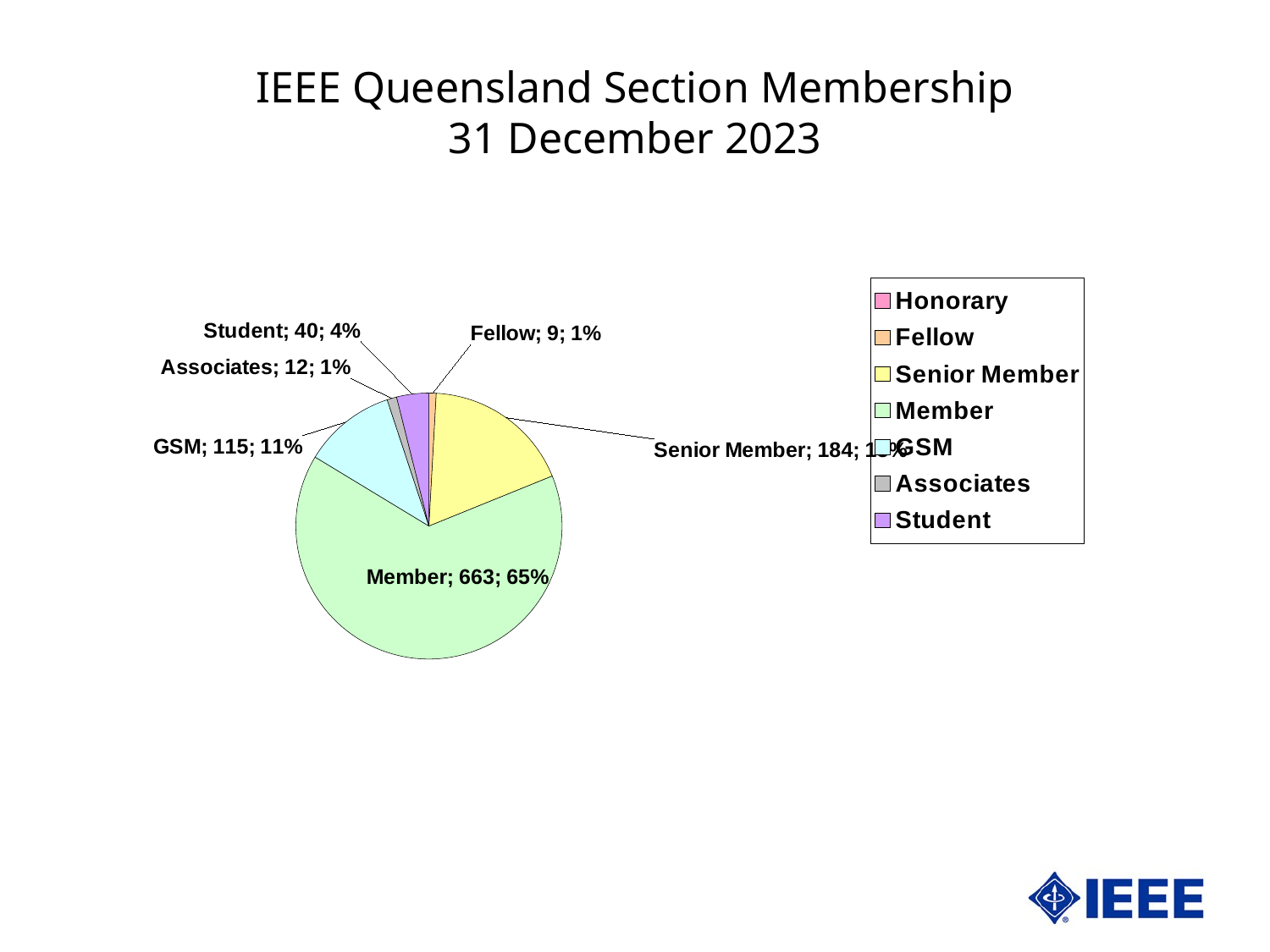
How many members are in the Member category? 663 What share of the pie does the Student slice represent? 4% What is the value for Fellow? 9 Which category has the largest slice of the pie? Member What is the value for GSM? 115 What is the difference between the Member value and the Senior Member value? 479 What share of the pie does the Member slice represent? 65% Which is larger, the value for Senior Member or the value for GSM? Senior Member What is the value for Associates? 12 What kind of chart is shown on the slide? pie chart What is the value for Student? 40 What percentage of the pie is the GSM slice? 11%